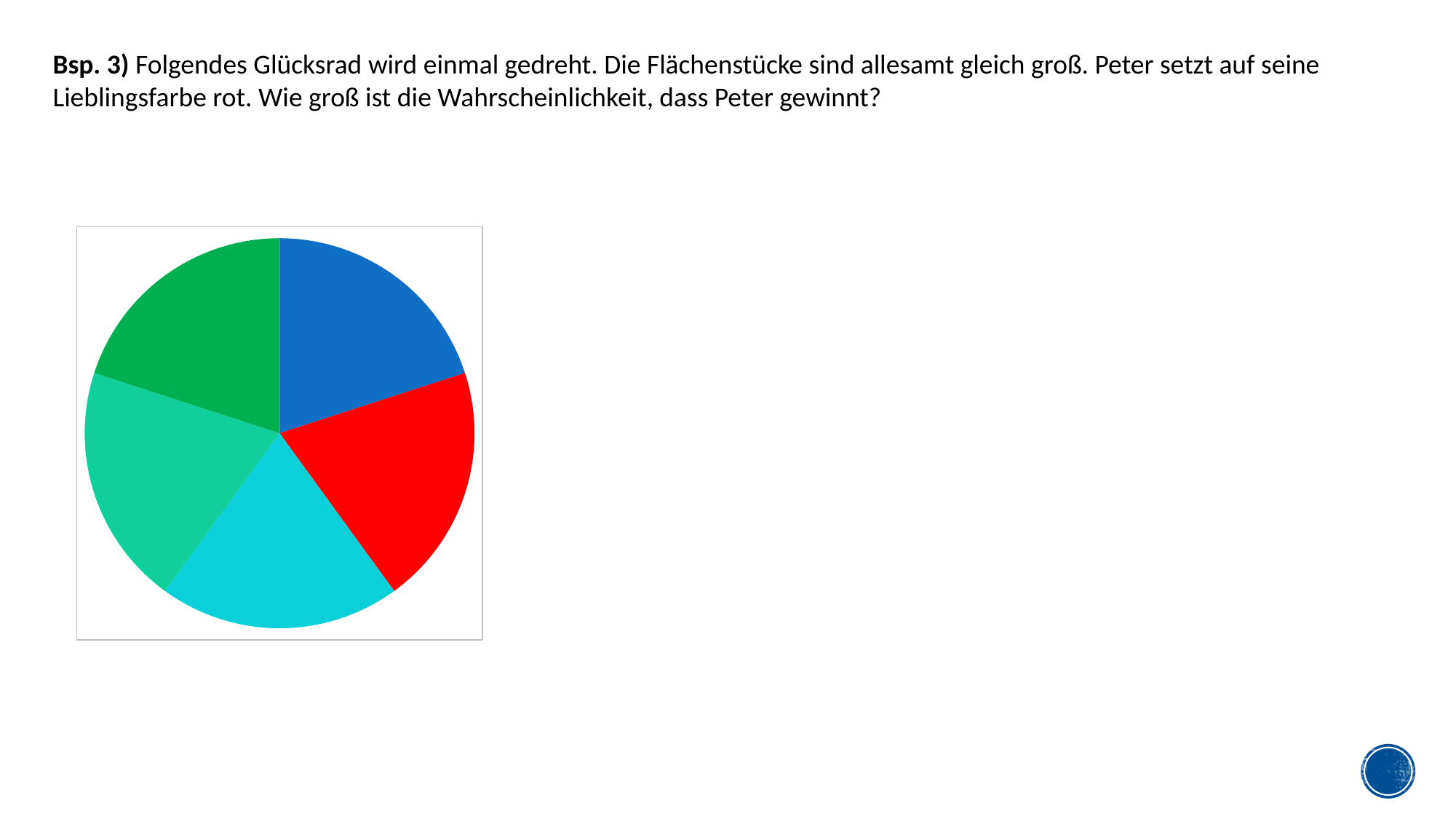
Does the pie chart have a legend? no What share of the pie chart does the red slice take up? 1/5 How many slices of the pie chart are red? 1 What kind of chart is shown on the slide? pie chart According to the slide, are the slices of the pie chart all the same size? yes How many slices does the pie chart have? 5